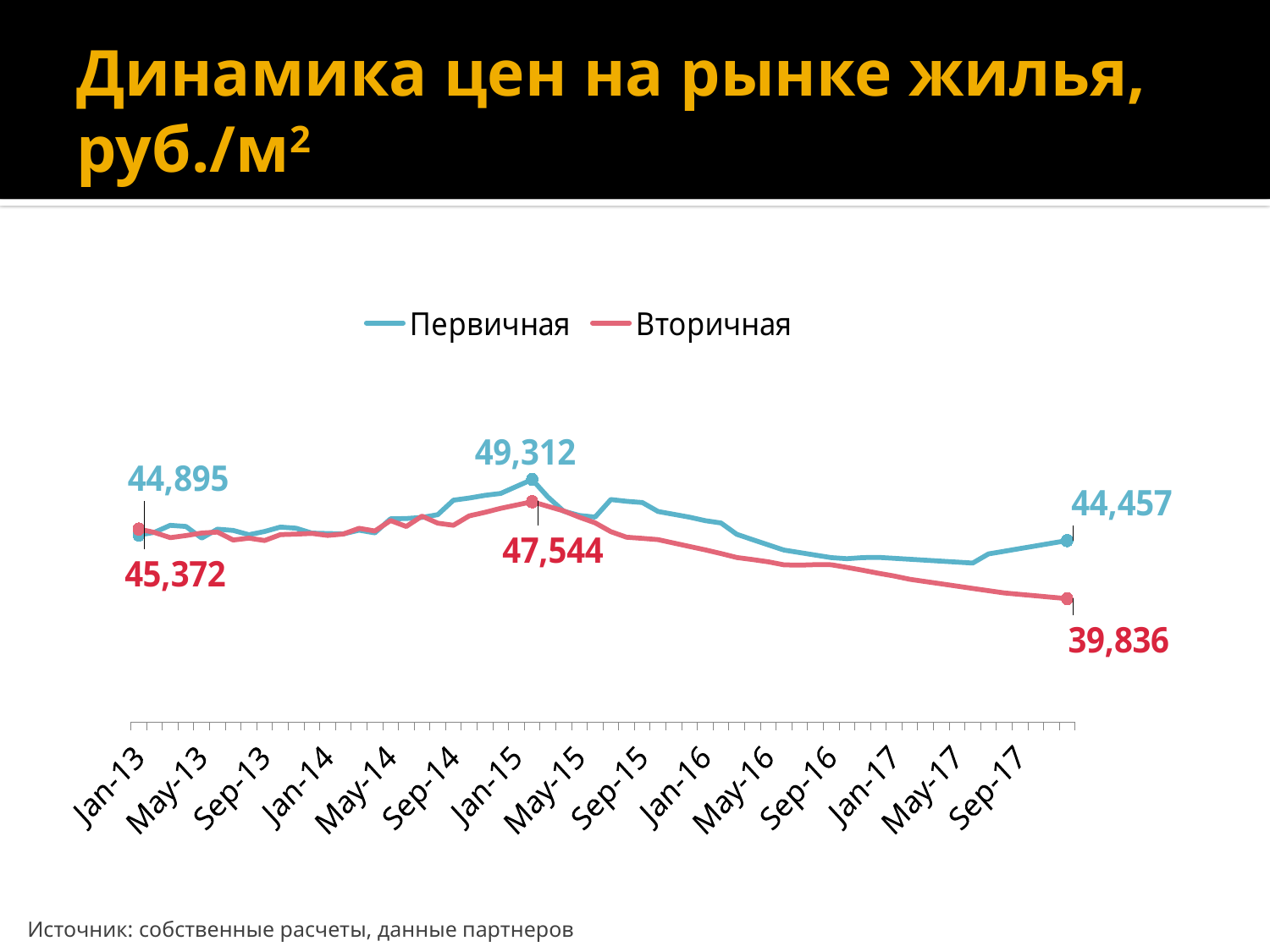
Which series has the higher value at the last point of the chart, Первичная or Вторичная? Первичная What type of chart is shown on the slide? line chart What is the labelled peak value of the Первичная series around Jan-15? 49,312 What is the labelled value of the Вторичная series around Jan-15? 47,544 What are the two series named in the legend? Первичная and Вторичная Does the Вторичная series rise or fall from its Jan-15 value to the end of the chart? fall What is the labelled value of the Вторичная series at the last point of the chart? 39,836 What is the difference between the Первичная and Вторичная values at the last point of the chart? 4,621 What is the labelled value of the Первичная series at the last point of the chart? 44,457 How many series does the legend list? 2 What is the labelled value of the Первичная series at Jan-13? 44,895 What is the labelled value of the Вторичная series at Jan-13? 45,372